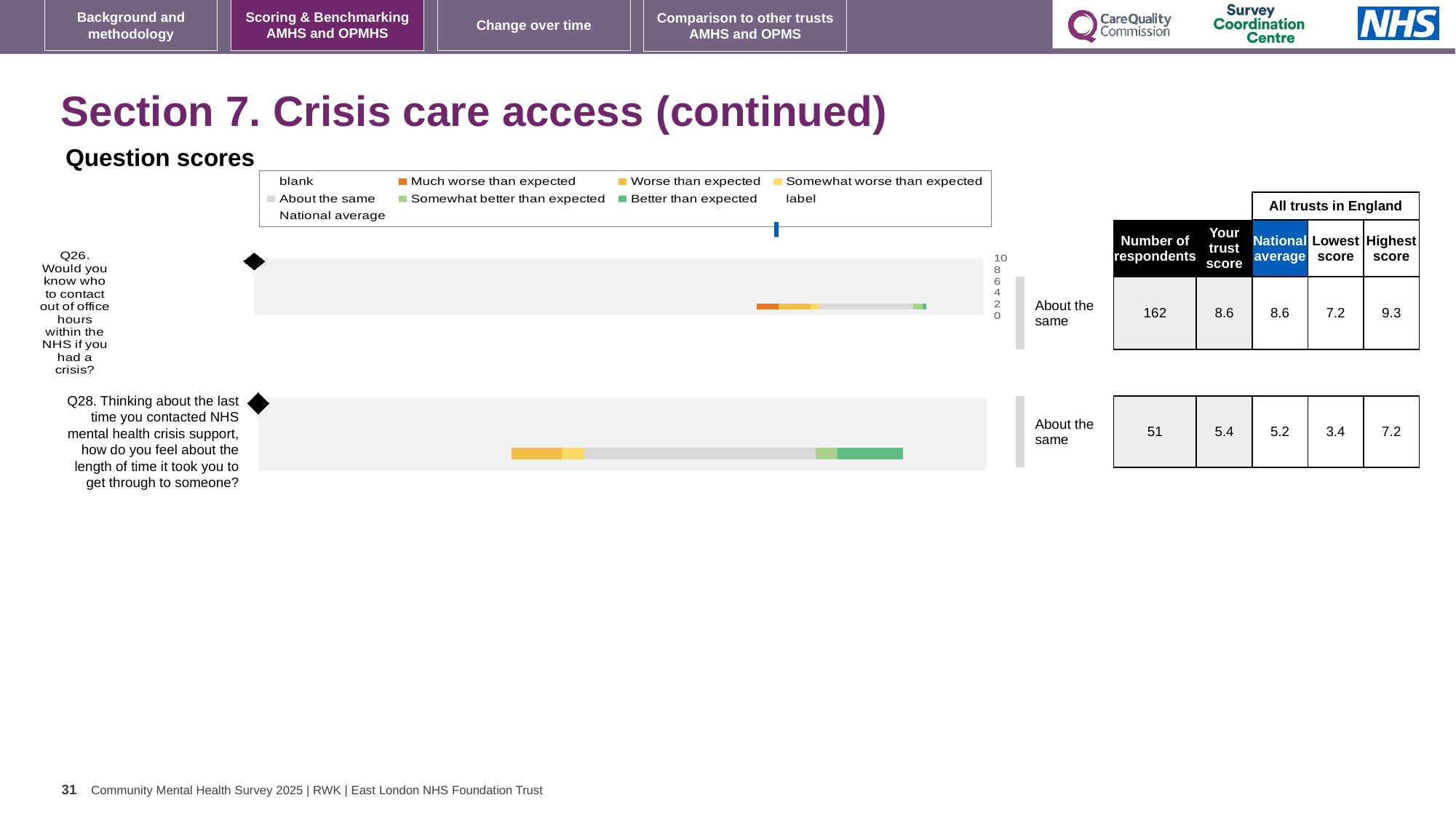
What is the difference between the highest score and the lowest score for Q26? 2.1 For Q28, which is larger: the trust score or the national average? Trust score What kind of chart is used to show the question scores for Q26 and Q28? Bar chart Which legend entry is shown in dark green? Better than expected What is the number of respondents for Q26? 162 How many questions are plotted in the question scores charts? 2 What benchmark category is shown next to the bar for Q26? About the same What is the national average for Q26? 8.6 What is the trust score for Q28? 5.4 What is the difference between the trust score and the national average for Q28? 0.2 What benchmark category is shown next to the bar for Q28? About the same Which legend entry is shown in orange? Much worse than expected